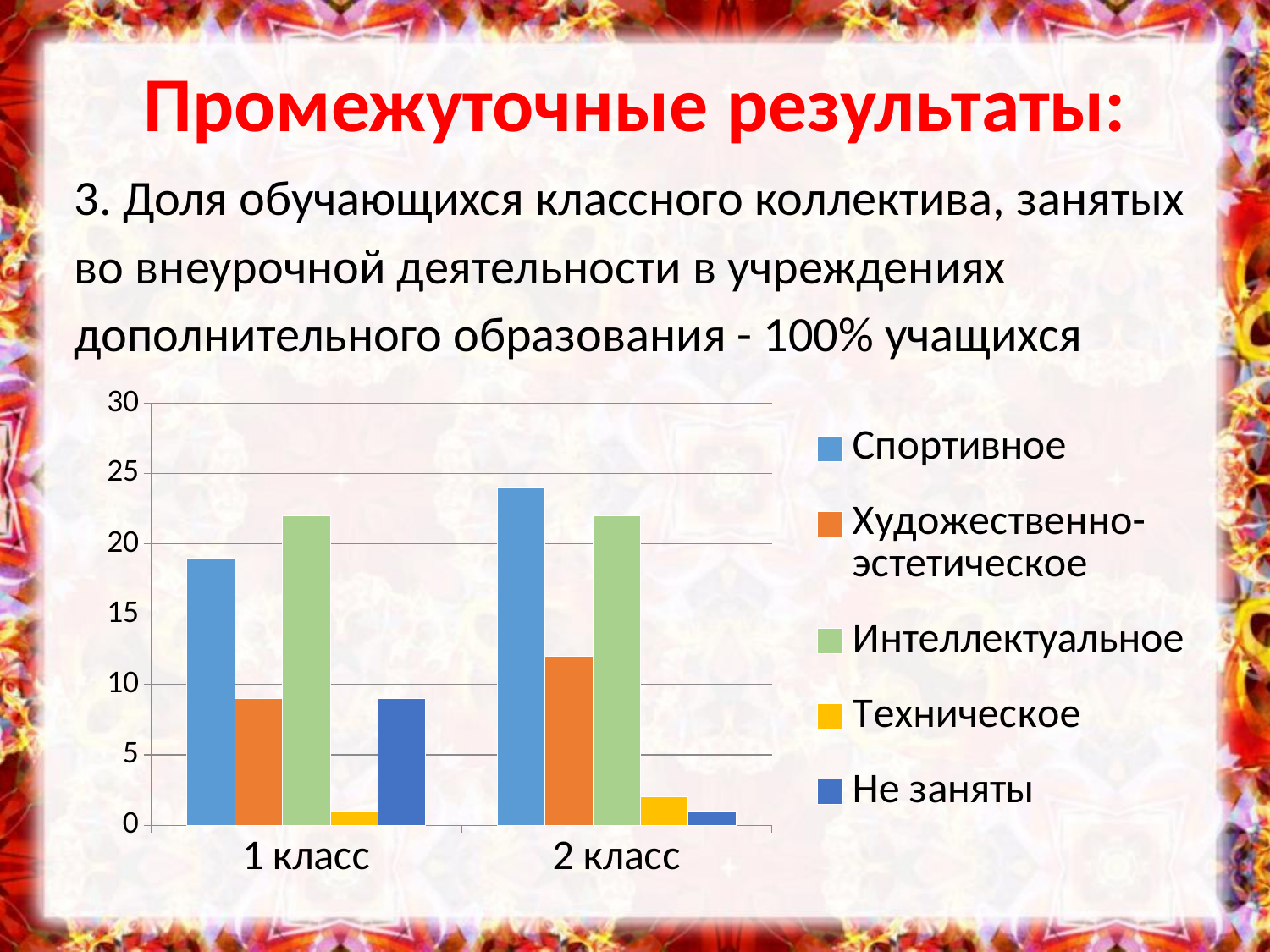
How many categories are shown on the x axis? 2 Is the value for Спортивное in 2 класс greater or less than 20? greater Is the value for Не заняты in 2 класс greater or less than 5? less How many series does the legend list? 5 Is the value for Спортивное in 1 класс greater or less than 15? greater Does the value for Не заняты rise or fall from 1 класс to 2 класс? fall What kind of chart is shown on the slide? bar chart Which is larger: Спортивное in 1 класс or Спортивное in 2 класс? Спортивное in 2 класс Which series has the highest bar for 1 класс? Интеллектуальное Which series has the highest bar for 2 класс? Спортивное Which series has the lowest bar for 1 класс? Техническое